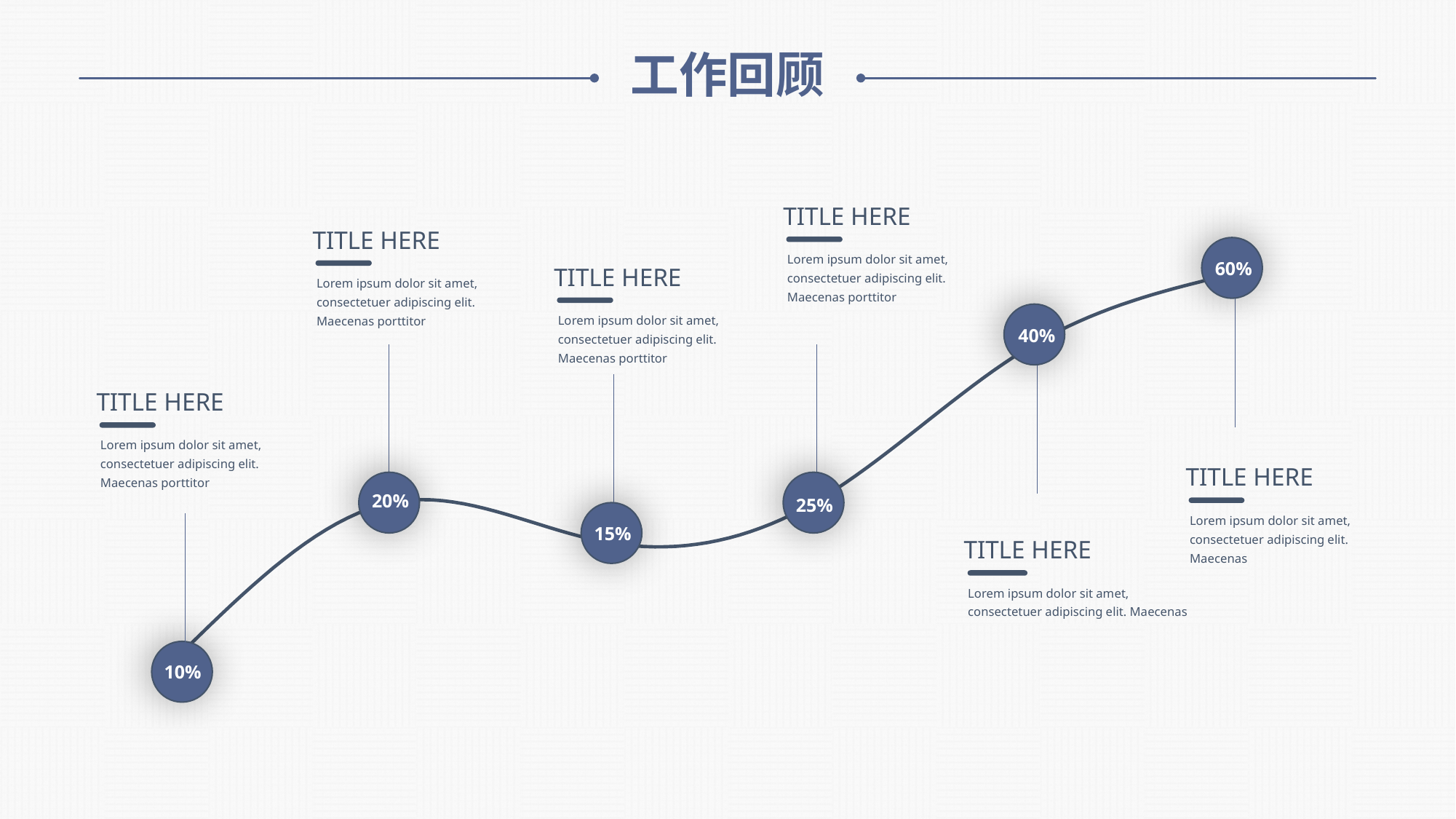
How many data points are plotted on the line? 6 Do the values generally rise or fall from left to right along the line? rise What kind of chart is shown on the slide? line chart What is the value of the first (leftmost) point on the line? 10% What is the value of the last (rightmost) point on the line? 60% What is the title of the slide? 工作回顾 What is the difference between the last point (60%) and the fifth point (40%)? 20% Which point has the lowest value? the first (leftmost) point, 10% Which point has the highest value? the last (rightmost) point, 60% What is the value of the fifth point from the left on the line? 40% Which is larger, the second point or the third point on the line? the second point (20%) What is the value of the third point from the left on the line? 15%